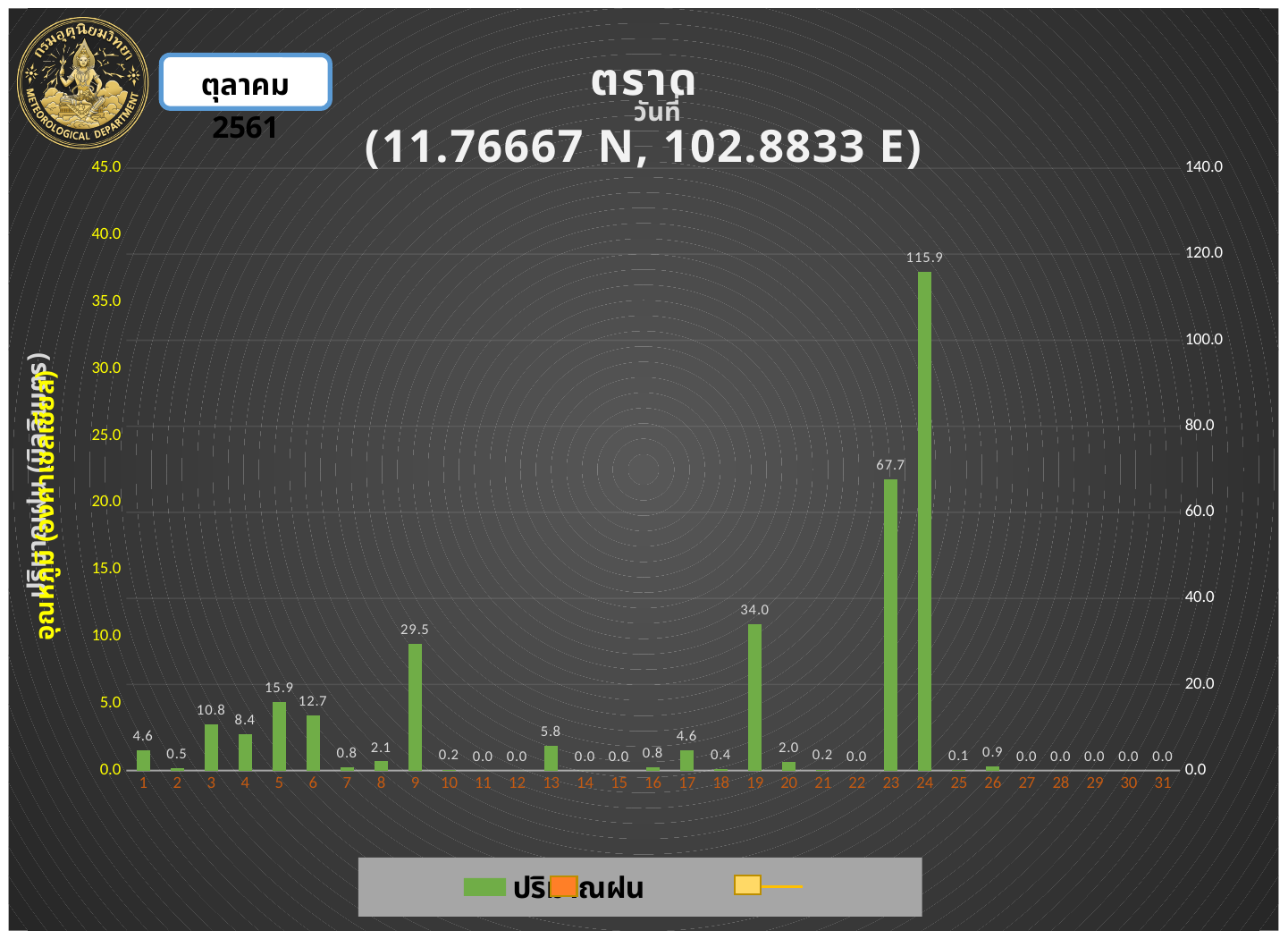
What coordinates are given in the chart title? 11.76667 N, 102.8833 E What is the rainfall value shown for day 24? 115.9 How many days are shown on the x axis? 31 What is the value shown for day 9? 29.5 What is the difference between the values for day 24 and day 23? 48.2 What is the difference between the values for day 19 and day 9? 4.5 Which is larger, the value for day 3 or the value for day 6? day 6 Is the value for day 23 greater or less than 60.0 on the right axis? greater What is the value shown for day 5? 15.9 Which day has the highest value? 24 What kind of chart is this? bar chart What is the value shown for day 19? 34.0